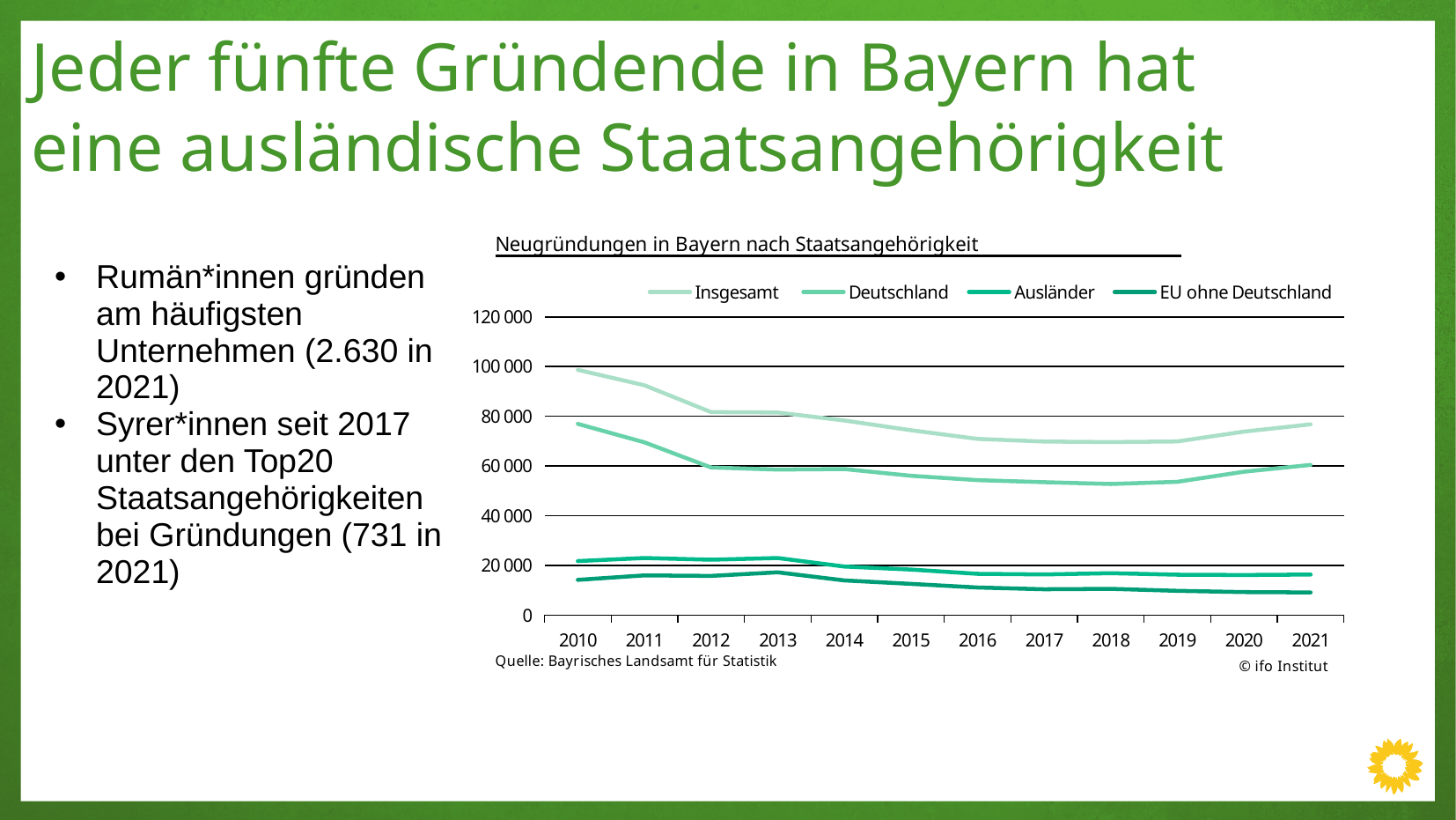
How many series does the legend of the chart list? 4 Is the value for Deutschland in 2010 greater or less than 80 000? less What kind of chart is shown on the slide? line chart Which series has the larger value in 2015: Insgesamt or Deutschland? Insgesamt Is the value for EU ohne Deutschland in 2021 greater or less than 20 000? less Which source is cited below the chart? Bayrisches Landsamt für Statistik Does the Insgesamt series rise or fall from 2010 to 2018? fall How many years are plotted along the x axis of the chart? 12 What is the title of the chart? Neugründungen in Bayern nach Staatsangehörigkeit In which year is the Insgesamt series at its highest? 2010 Which series has the larger value in 2013: Ausländer or EU ohne Deutschland? Ausländer Is the value for Insgesamt in 2010 greater or less than 80 000? greater